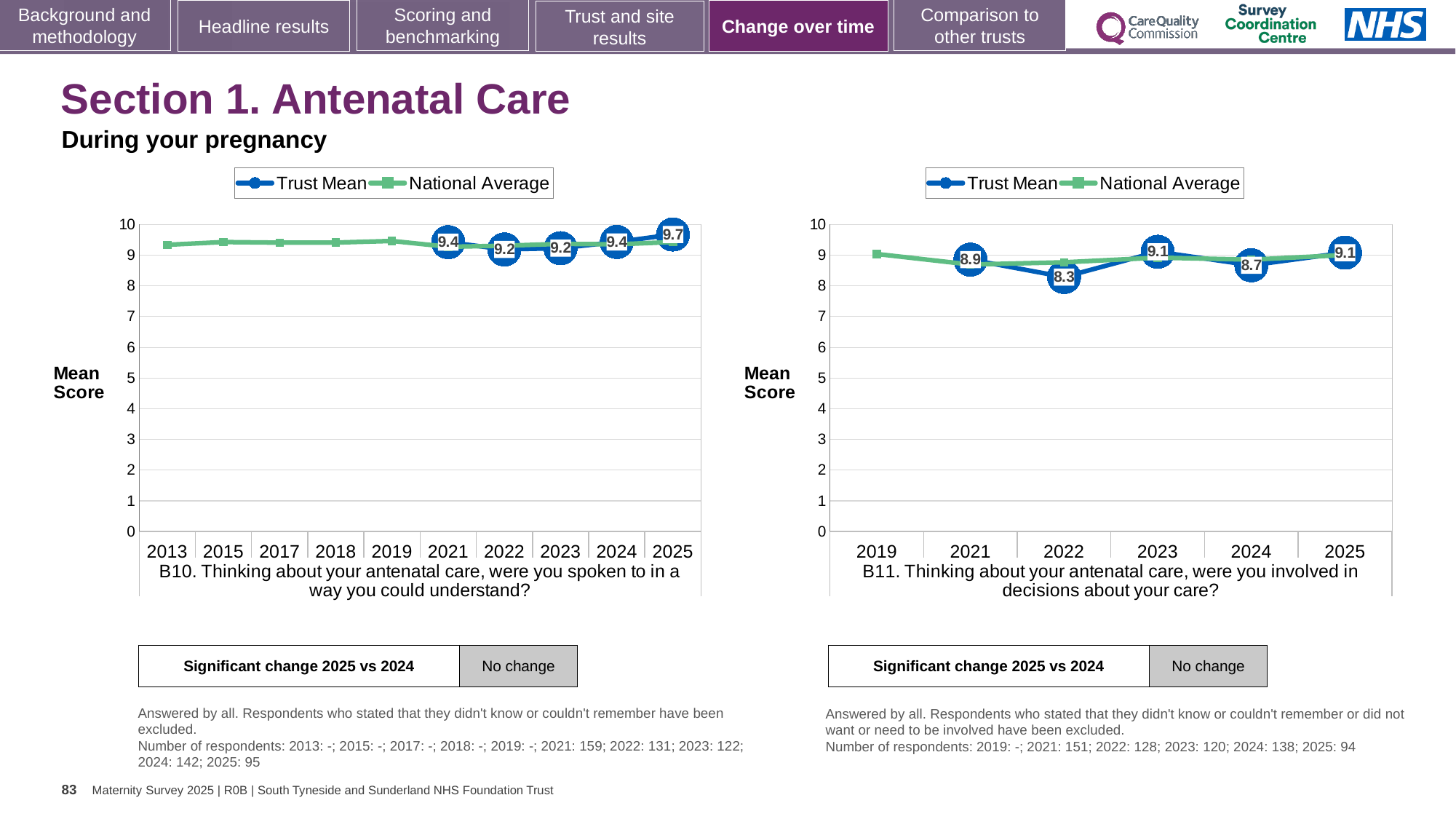
How many series does the legend of the B10 chart (left) list? 2 In the B11 chart (right), is the National Average for 2019 greater or less than 8? greater In the B11 chart (right), what is the Trust Mean for 2022? 8.3 In the B11 chart (right), is the Trust Mean for 2024 or for 2023 larger? 2023 In the B11 chart (right), what is the difference between the Trust Mean for 2023 and for 2022? 0.8 In the B10 chart (left), what is the difference between the Trust Mean for 2025 and for 2024? 0.3 In the B10 chart (left), what is the Trust Mean for 2022? 9.2 In the B10 chart (left), which year has the highest Trust Mean? 2025 What kind of chart is the B11 chart (right)? Line chart In the B10 chart (left), what is the Trust Mean for 2025? 9.7 In the B11 chart (right), which year has the lowest Trust Mean? 2022 In the B10 chart (left), how many years are shown on the x axis? 10